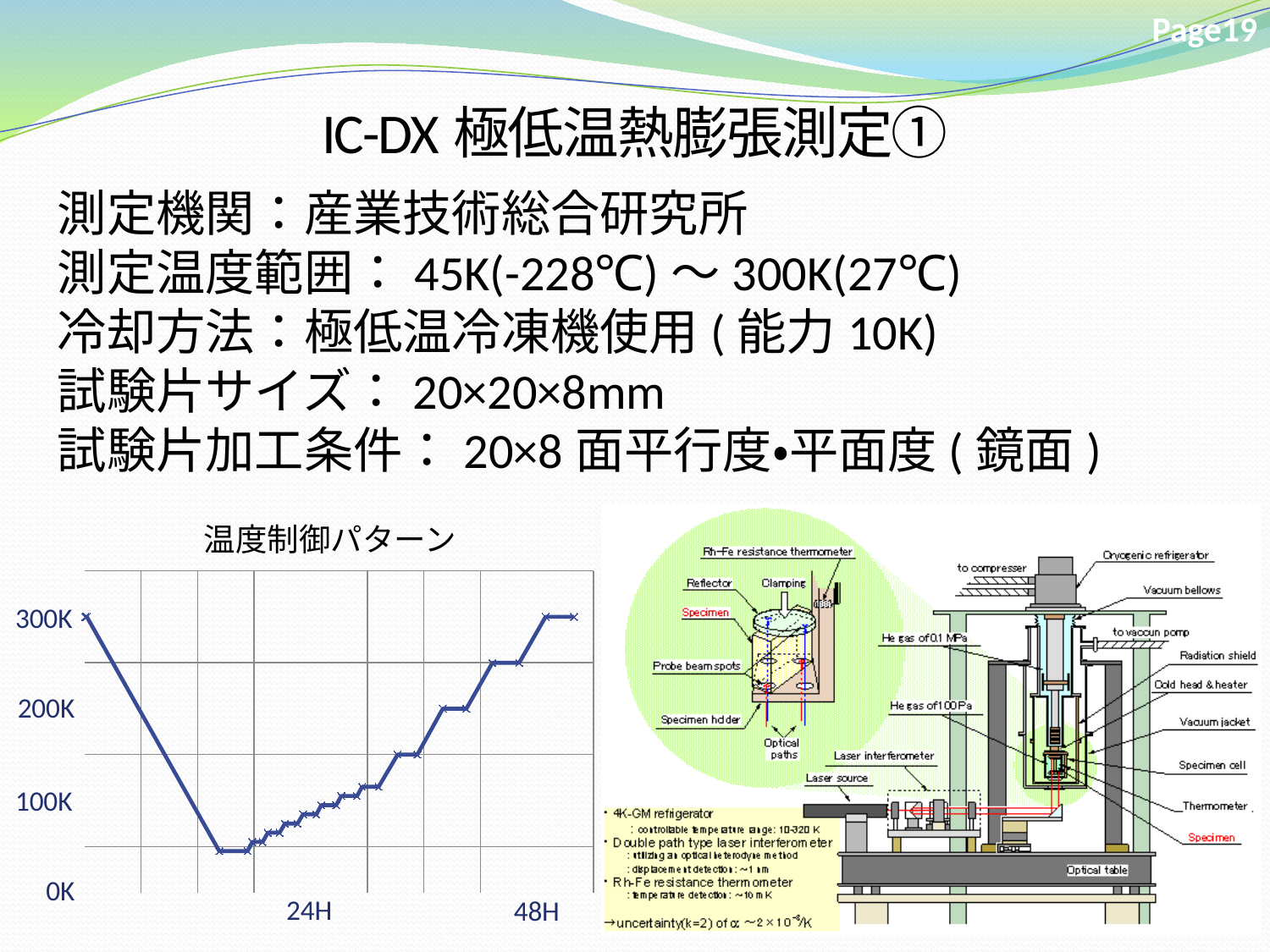
In the 温度制御パターン chart, is the value at 24H greater or less than 200K? less In the 温度制御パターン chart, does the line rise or fall during the first part of the time axis? fall In the 温度制御パターン chart, is the lowest point of the line greater or less than 100K? less In the 温度制御パターン chart, does the line rise or fall after reaching its lowest point? rise What kind of chart is the 温度制御パターン chart on the slide? line chart How many lines are plotted in the 温度制御パターン chart? 1 In the 温度制御パターン chart, which is larger: the starting value or the lowest value of the line? the starting value In the 温度制御パターン chart, what temperature does the line end at on the right? 300K In the 温度制御パターン chart, what temperature does the line start at on the left? 300K In the 温度制御パターン chart, is the value at 48H greater or less than 200K? greater What is the highest tick label on the vertical axis of the 温度制御パターン chart? 300K What is the title of the chart on the left of the slide? 温度制御パターン